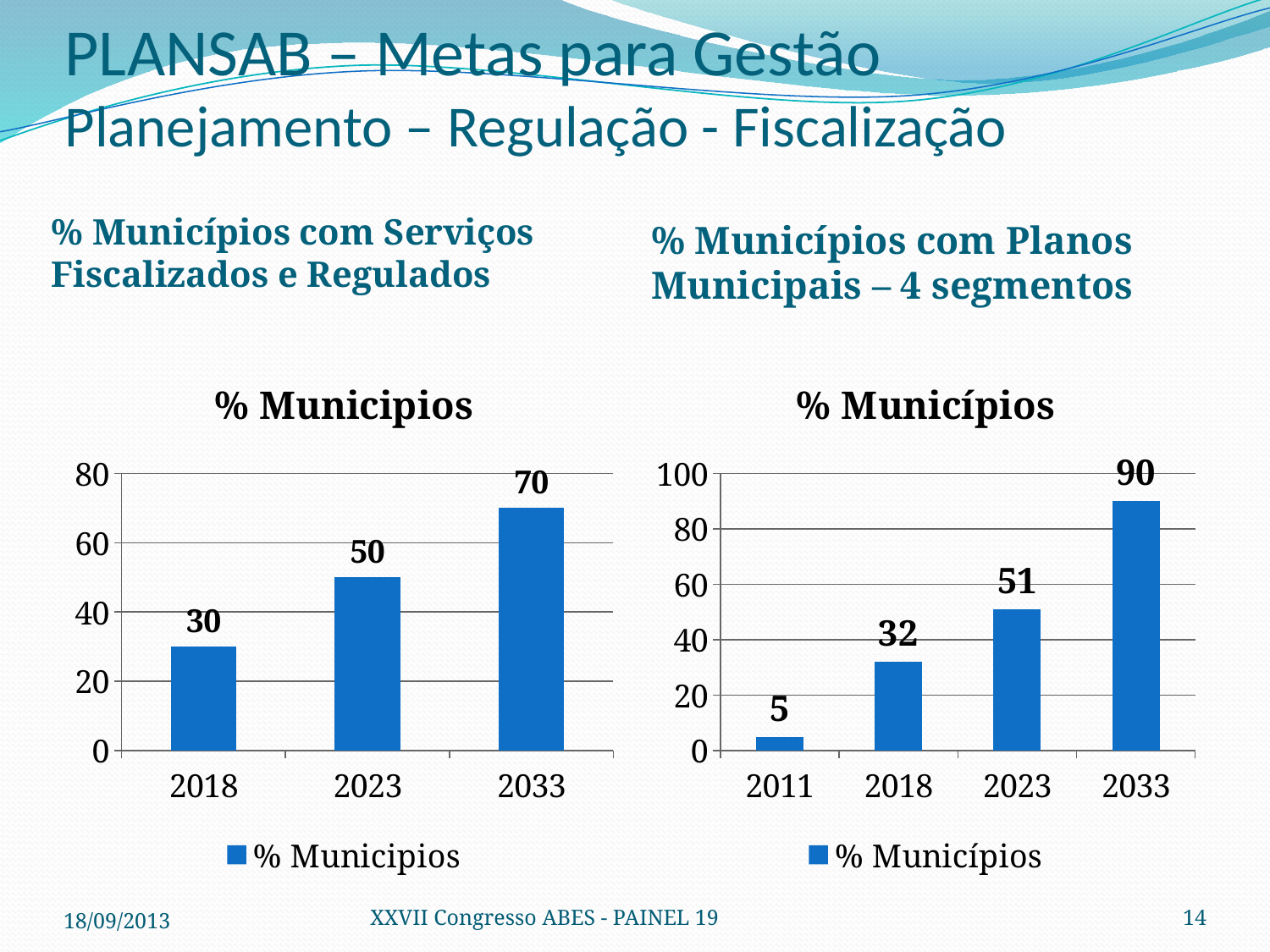
How many years are shown on the x axis of the left chart (% Municípios com Serviços Fiscalizados e Regulados)? 3 In the left chart (% Municípios com Serviços Fiscalizados e Regulados), which year has the highest value? 2033 In the left chart (% Municípios com Serviços Fiscalizados e Regulados), what is the value for 2023? 50 In the left chart (% Municípios com Serviços Fiscalizados e Regulados), what is the difference between the values for 2033 and 2018? 40 In the right chart (% Municípios com Planos Municipais – 4 segmentos), what is the value for 2011? 5 In the right chart (% Municípios com Planos Municipais – 4 segmentos), what is the value for 2023? 51 In the right chart (% Municípios com Planos Municipais – 4 segmentos), which year has the lowest value? 2011 Which is larger: the value for 2023 in the left chart or the value for 2023 in the right chart? The right chart (51) In the right chart (% Municípios com Planos Municipais – 4 segmentos), what is the difference between the values for 2033 and 2023? 39 In the right chart (% Municípios com Planos Municipais – 4 segmentos), do the values rise or fall from 2011 to 2033? Rise How many years are shown on the x axis of the right chart (% Municípios com Planos Municipais – 4 segmentos)? 4 What kind of chart is the left chart (% Municípios com Serviços Fiscalizados e Regulados)? Bar chart